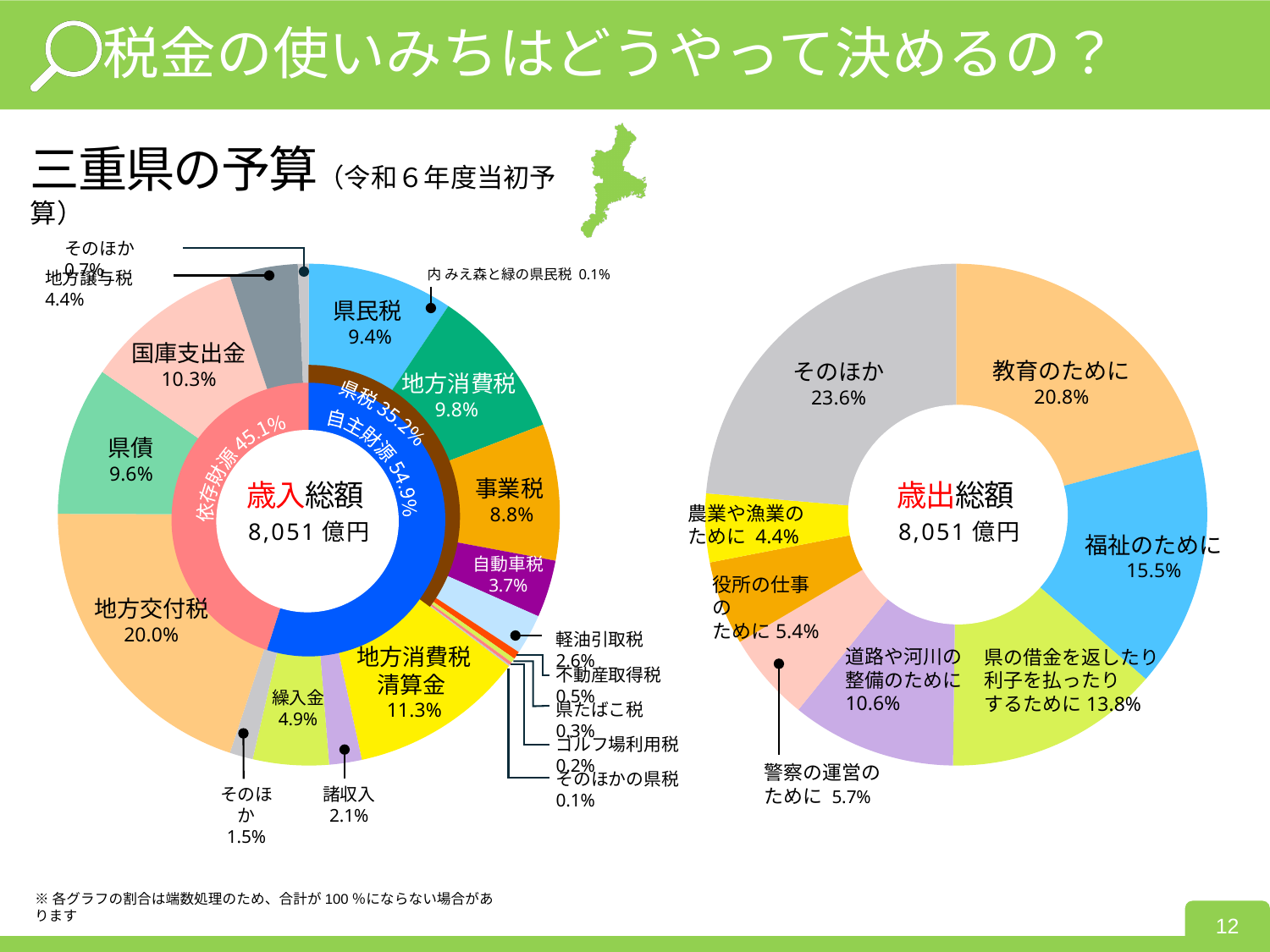
In the 歳出総額 chart on the right, which category has the smallest share? 農業や漁業のために In the 歳入総額 chart on the left, which is larger: 県債 or 事業税? 県債 In the 歳入総額 chart on the left, what is the share for 国庫支出金? 10.3% In the 歳出総額 chart on the right, what is the difference between 福祉のために and 道路や河川の整備のために? 4.9% How many categories are shown in the 歳出総額 chart on the right? 8 What type of chart is the 歳出総額 chart on the right? Donut (pie) chart In the 歳入総額 chart on the left, what is the share for 地方交付税? 20.0% In the 歳出総額 chart on the right, which labelled category has the largest share? そのほか In the 歳入総額 chart on the left, what is the difference between 地方消費税清算金 and 繰入金? 6.4% In the 歳出総額 chart on the right, what is the share for 警察の運営のために? 5.7% In the 歳出総額 chart on the right, what is the share for 教育のために? 20.8% What total amount is shown in the centre of the 歳入総額 chart on the left? 8,051 億円